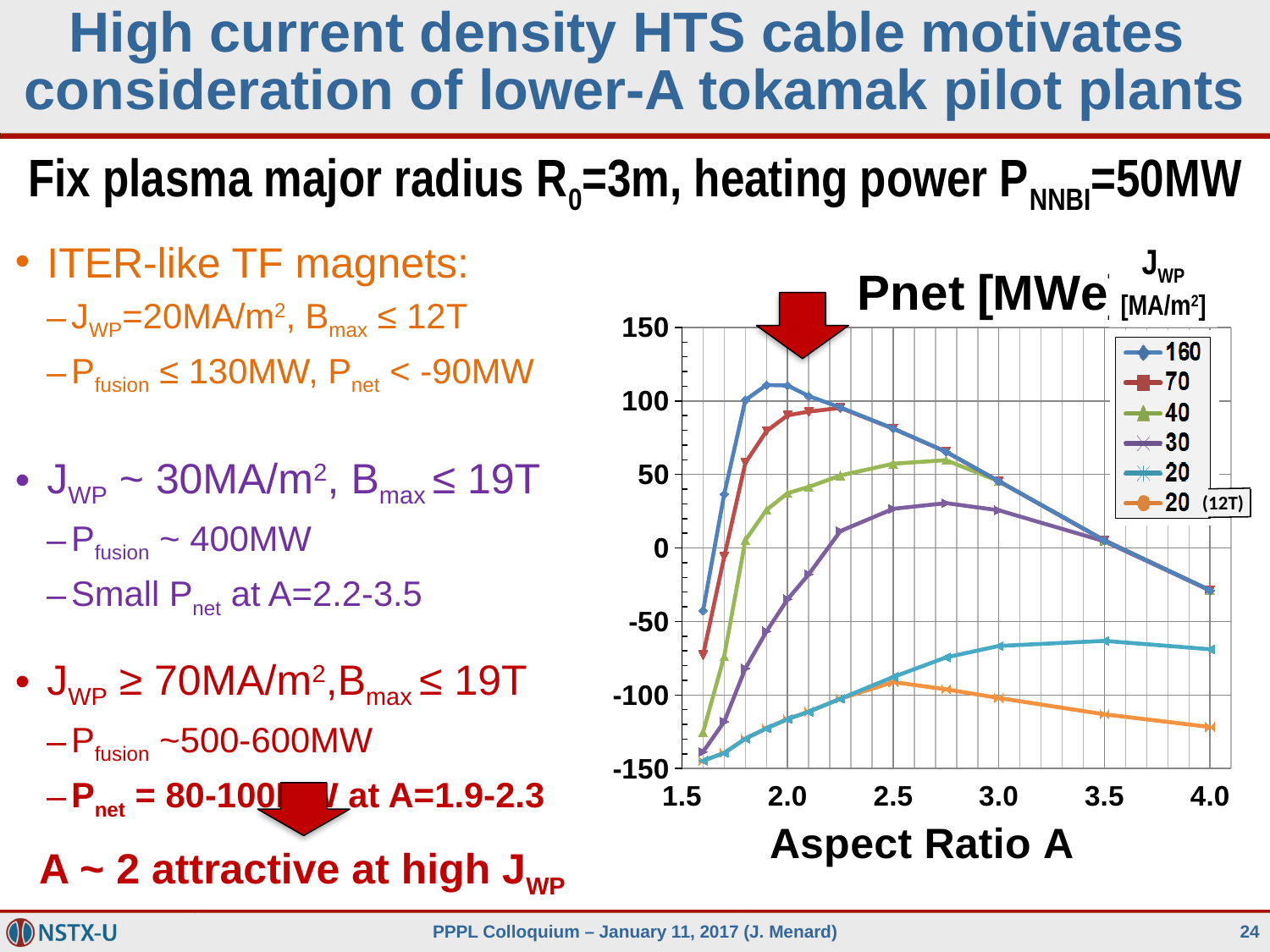
Does the 160 series rise or fall as A increases from 2.0 to 4.0? fall At A=4.0, which series has the larger value, 20 or 20 (12T)? 20 What is the label of the chart's x axis? Aspect Ratio A What kind of chart is shown on the slide? line chart Is the value of the 30 series at A=2.0 greater or less than 0? less What quantity does the chart's legend say the series are distinguished by? J_WP [MA/m²] At A=2.0, which series has the larger value, 160 or 70? 160 Is the value of the 160 series at A=2.0 greater or less than 100? greater How many series does the chart's legend list? 6 Is the value of the 70 series at A=2.5 greater or less than 50? greater Which series reaches the highest Pnet value on the chart? 160